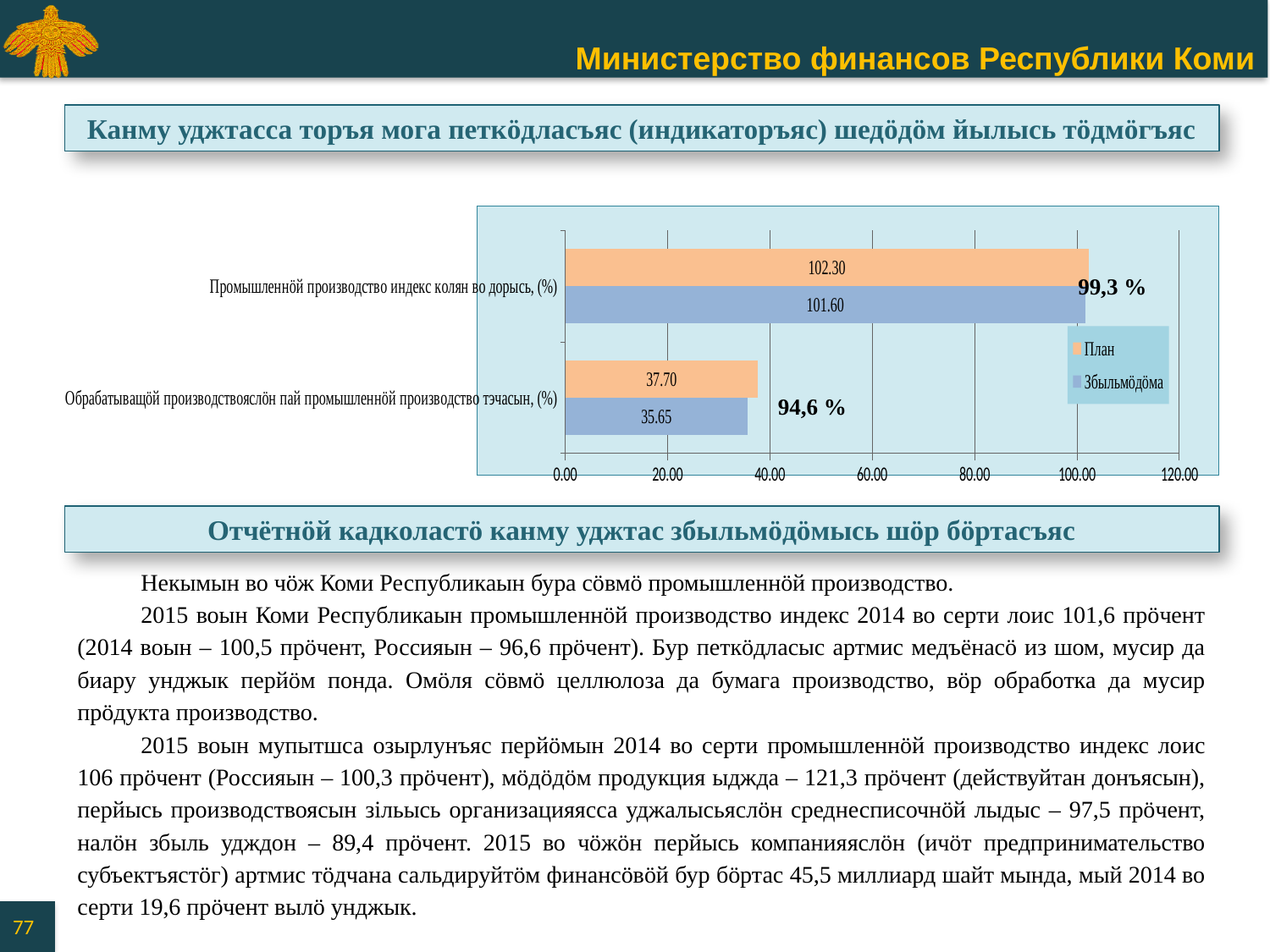
Which series has the larger value for "Промышленнöй производство индекс колян во дорысь, (%)", План or Збыльмöдöма? План What is the План value for "Обрабатывающöй производствояслöн пай промышленнöй производство тэчасын, (%)"? 37.70 Which category has the highest План value? Промышленнöй производство индекс колян во дорысь, (%) What is the Збыльмöдöма value for "Промышленнöй производство индекс колян во дорысь, (%)"? 101.60 What is the difference between the План and Збыльмöдöма values for "Промышленнöй производство индекс колян во дорысь, (%)"? 0.70 What percentage is printed next to the bars for "Обрабатывающöй производствояслöн пай промышленнöй производство тэчасын, (%)"? 94,6 % How many series does the chart legend list? 2 What is the Збыльмöдöма value for "Обрабатывающöй производствояслöн пай промышленнöй производство тэчасын, (%)"? 35.65 What is the План value for "Промышленнöй производство индекс колян во дорысь, (%)"? 102.30 How many categories are plotted on the chart? 2 What is the difference between the План and Збыльмöдöма values for "Обрабатывающöй производствояслöн пай промышленнöй производство тэчасын, (%)"? 2.05 What kind of chart is shown on the slide? bar chart